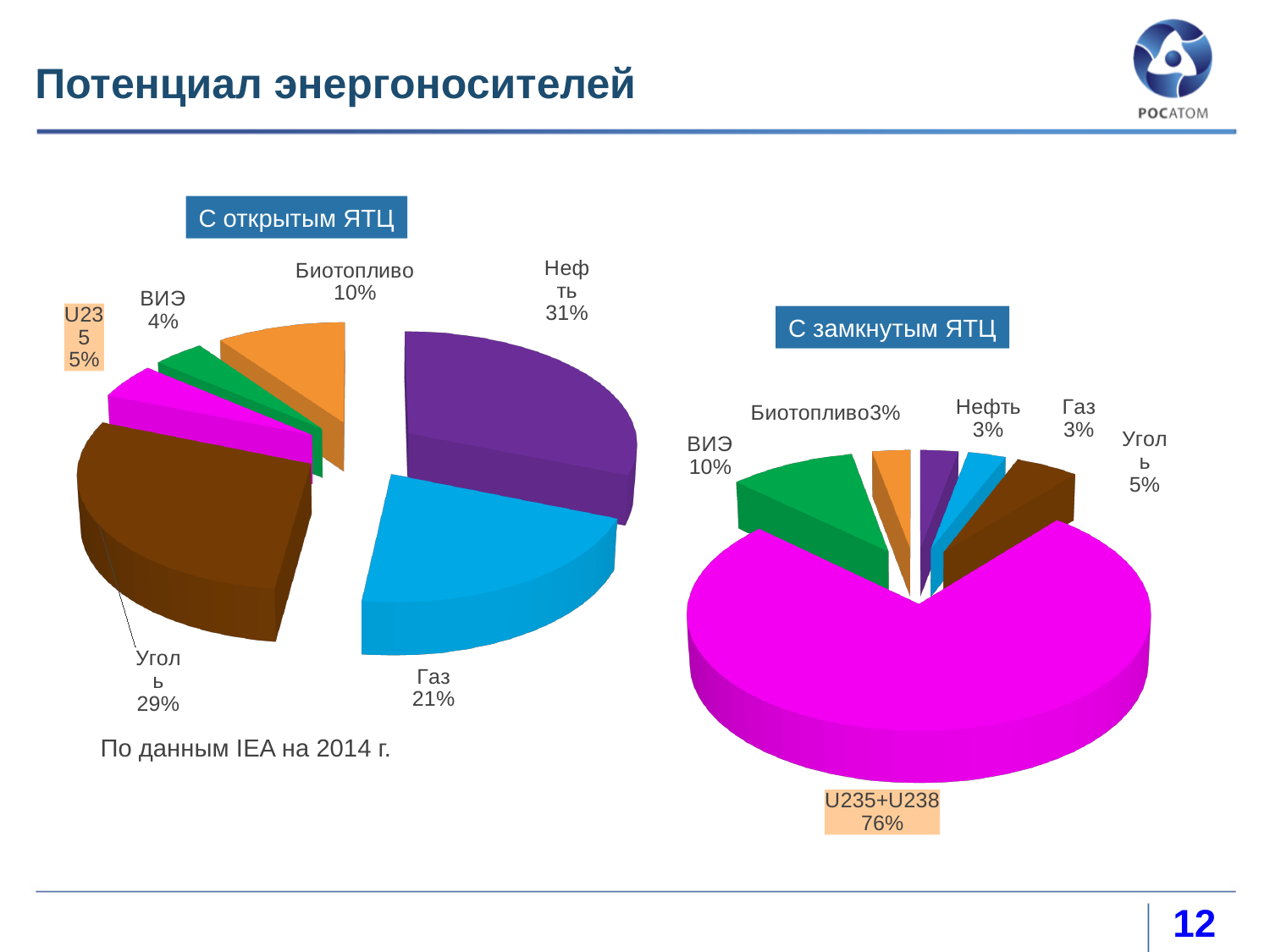
In the 'С открытым ЯТЦ' pie chart, what is the difference between the shares of Нефть and Газ? 10% In the 'С открытым ЯТЦ' pie chart, which category has the smallest share? ВИЭ According to the note on the slide, what is the data source and year for the charts? IEA, 2014 In the 'С открытым ЯТЦ' pie chart, what share does Уголь have? 29% What type of chart is used for 'С замкнутым ЯТЦ'? Pie chart In the 'С замкнутым ЯТЦ' pie chart, which category has the largest share? U235+U238 In the 'С замкнутым ЯТЦ' pie chart, what share does ВИЭ have? 10% In the 'С открытым ЯТЦ' pie chart, how many slices are there? 6 In the 'С замкнутым ЯТЦ' pie chart, what share does U235+U238 have? 76% In the 'С замкнутым ЯТЦ' pie chart, which is larger, the share of Уголь or the share of Газ? Уголь In the 'С открытым ЯТЦ' pie chart, which category has the largest share? Нефть In the 'С открытым ЯТЦ' pie chart, what share does Нефть have? 31%